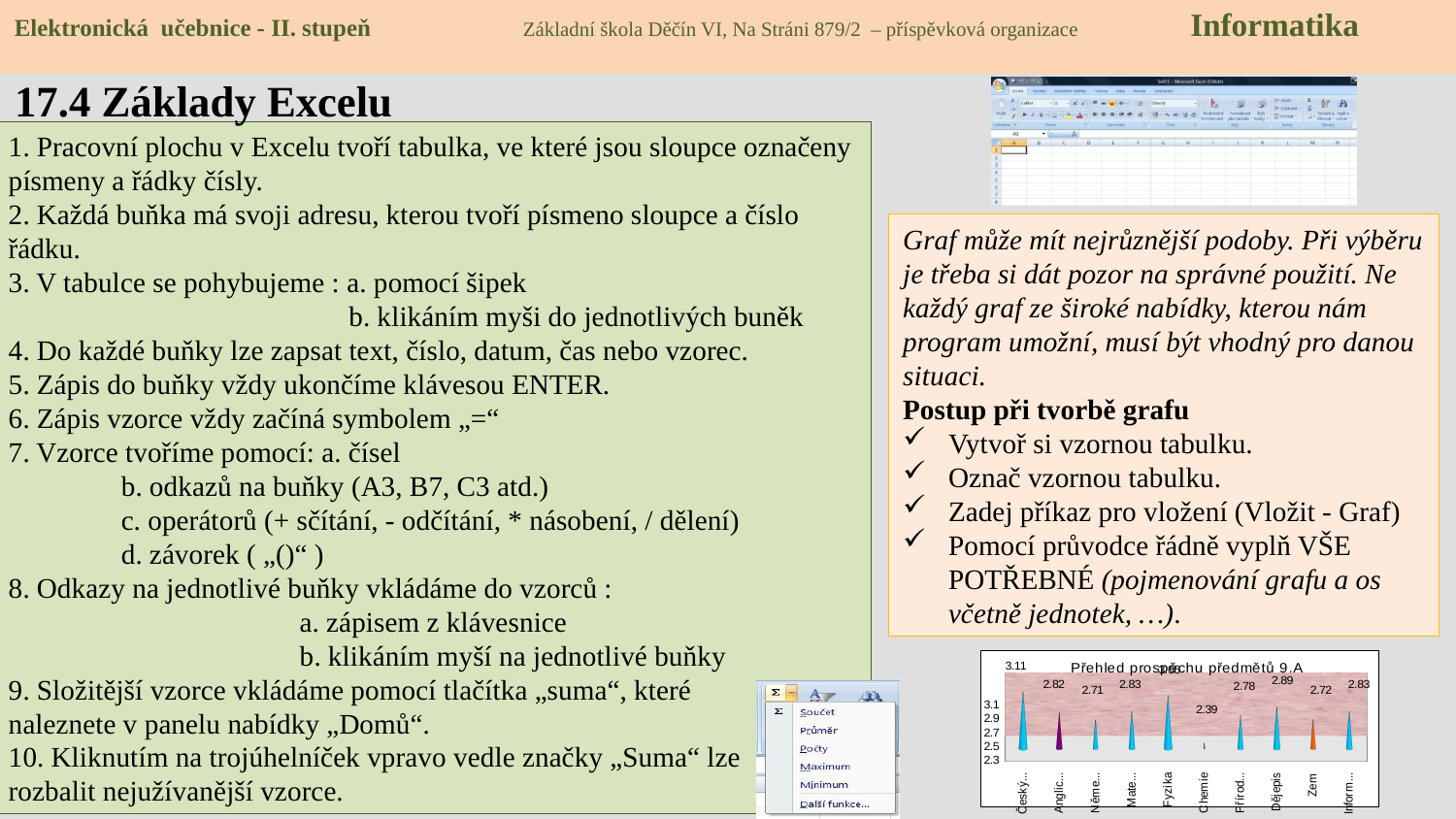
What is the title of the chart at the bottom right of the slide? Přehled prospěchu předmětů 9.A In the chart "Přehled prospěchu předmětů 9.A", what is the value for Zem? 2.72 In the chart "Přehled prospěchu předmětů 9.A", what is the value for Chemie? 2.39 In the chart "Přehled prospěchu předmětů 9.A", what is the difference between the values for Dějepis and Chemie? 0.50 How many categories (subjects) are plotted in the chart "Přehled prospěchu předmětů 9.A"? 10 What kind of chart is the chart titled "Přehled prospěchu předmětů 9.A"? bar chart In the chart "Přehled prospěchu předmětů 9.A", which is larger, the value for Dějepis or the value for Zem? Dějepis In the chart "Přehled prospěchu předmětů 9.A", which subject has the highest value? Český (the first category) In the chart "Přehled prospěchu předmětů 9.A", what is the difference between the values for Zem and Chemie? 0.33 In the chart "Přehled prospěchu předmětů 9.A", which subject has the lowest value? Chemie In the chart "Přehled prospěchu předmětů 9.A", is the value for Fyzika greater or less than 2.7? greater In the chart "Přehled prospěchu předmětů 9.A", what is the value for Dějepis? 2.89